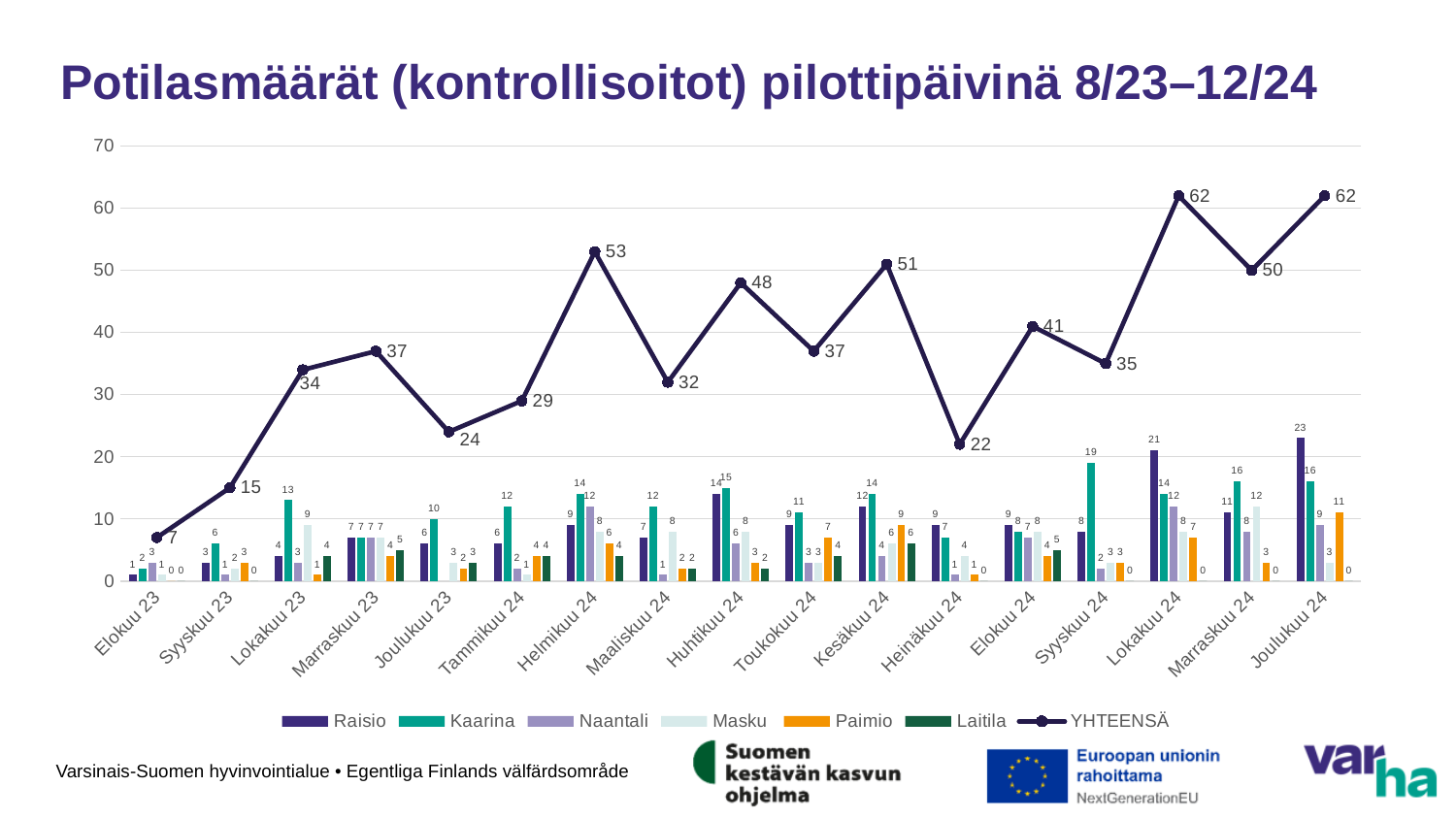
How many series does the legend list? 7 How many months are shown on the x axis? 17 Which is larger, the YHTEENSÄ value for Kesäkuu 24 or for Heinäkuu 24? Kesäkuu 24 What is the title of the chart? Potilasmäärät (kontrollisoitot) pilottipäivinä 8/23–12/24 What is the value for Raisio in Joulukuu 24? 23 What is the difference between the YHTEENSÄ values for Lokakuu 24 and Marraskuu 24? 12 What is the YHTEENSÄ value for Helmikuu 24? 53 Which municipality has the highest bar in Lokakuu 24? Raisio What kind of chart is this? Combined bar and line chart Is the YHTEENSÄ value for Huhtikuu 24 greater or less than 40? greater In which month is the YHTEENSÄ line lowest? Elokuu 23 What is the value for Kaarina in Syyskuu 24? 19